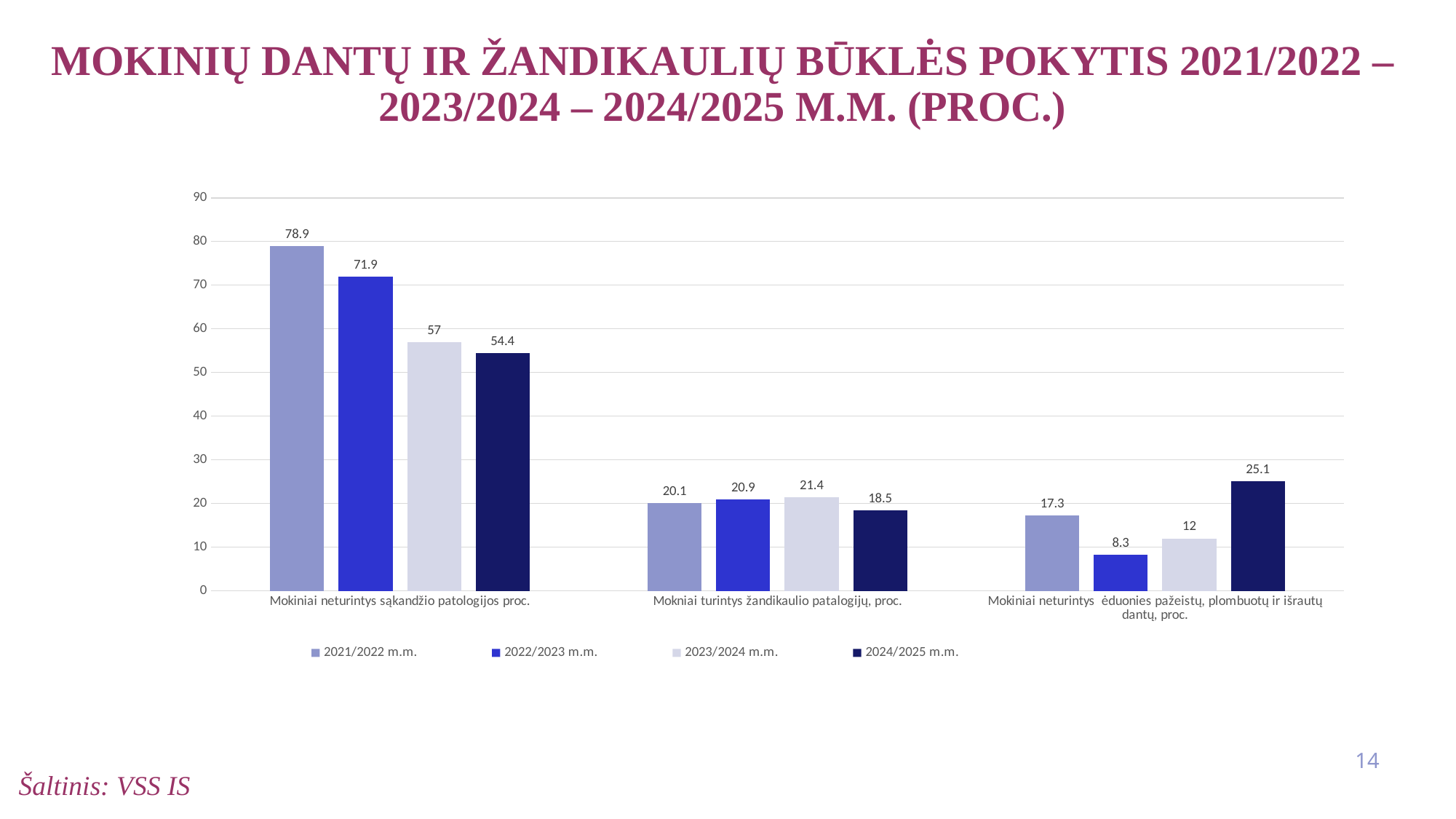
Which is larger in the category "Mokniai turintys žandikaulio patalogijų, proc.": the 2022/2023 m.m. value or the 2024/2025 m.m. value? 2022/2023 m.m. What is the value for 2021/2022 m.m. in the category "Mokiniai neturintys sąkandžio patologijos proc."? 78.9 Which series has the lowest value in the category "Mokiniai neturintys ėduonies pažeistų, plombuotų ir išrautų dantų, proc."? 2022/2023 m.m. How many series does the legend list? 4 How many categories are shown on the x axis? 3 What is the value for 2023/2024 m.m. in the category "Mokniai turintys žandikaulio patalogijų, proc."? 21.4 What is the value for 2024/2025 m.m. in the category "Mokiniai neturintys ėduonies pažeistų, plombuotų ir išrautų dantų, proc."? 25.1 Which series has the highest value in the category "Mokiniai neturintys sąkandžio patologijos proc."? 2021/2022 m.m. Do the values in the category "Mokiniai neturintys sąkandžio patologijos proc." rise or fall from 2021/2022 m.m. to 2024/2025 m.m.? fall What is the difference between the 2021/2022 m.m. and 2024/2025 m.m. values in the category "Mokiniai neturintys sąkandžio patologijos proc."? 24.5 What kind of chart is shown on the slide? bar chart Is the 2023/2024 m.m. value in the category "Mokiniai neturintys sąkandžio patologijos proc." greater or less than 50? greater